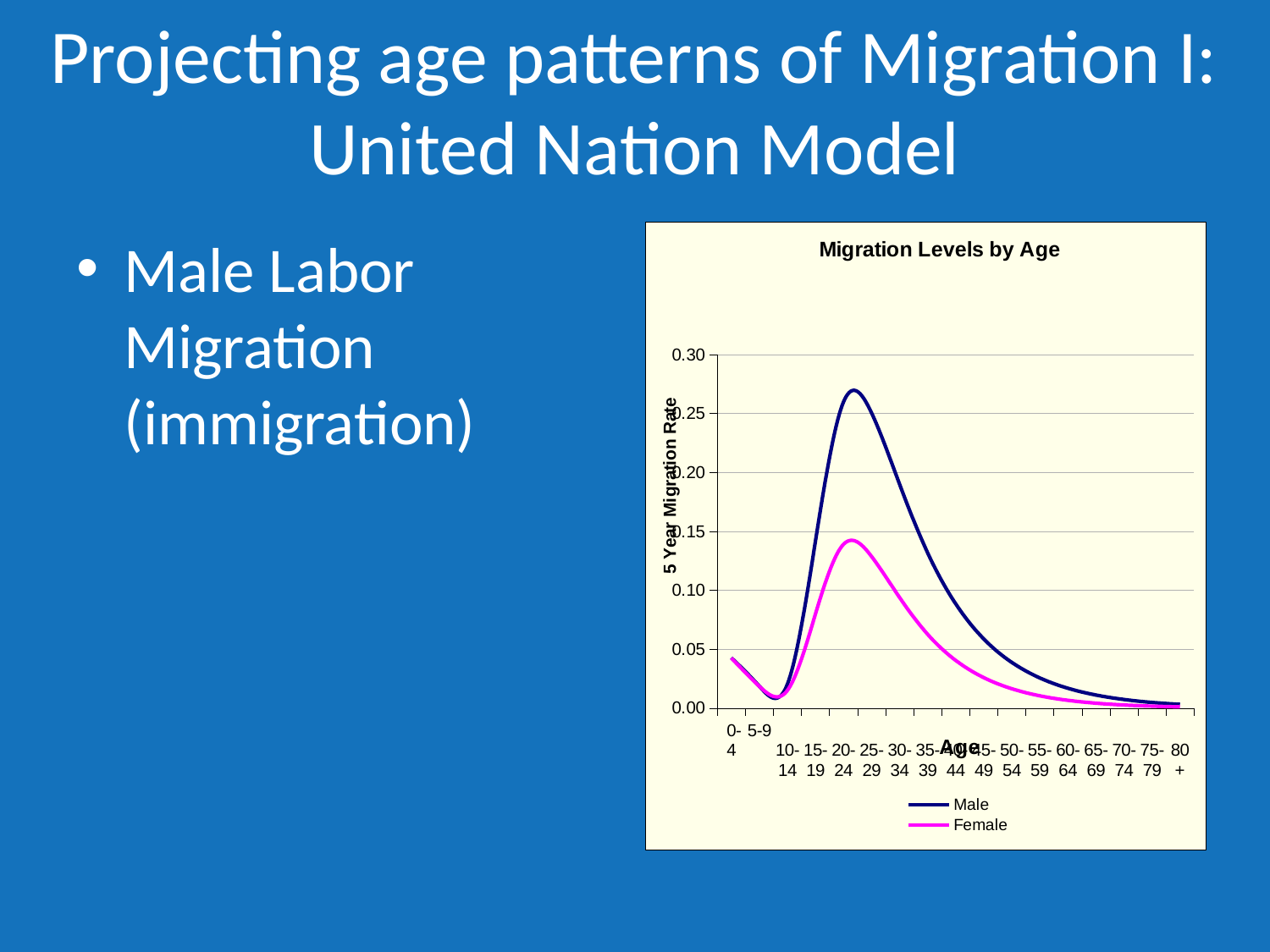
Is the Male value for the 10-14 age group greater or less than 0.05? less What is the title of the chart? Migration Levels by Age What is the label of the vertical axis of the chart? 5 Year Migration Rate How many age groups are shown along the x axis of the chart? 17 Do the Male values rise or fall along the x axis from the 30-34 age group to the 80+ age group? fall Which series reaches the higher peak value, Male or Female? Male What type of chart is shown on the slide? Line chart How many series does the legend of the chart list? 2 Is the Male value for the 80+ age group greater or less than 0.05? less Is the peak value of the Female series greater or less than 0.10? greater At the 25-29 age group, which series has the larger value, Male or Female? Male